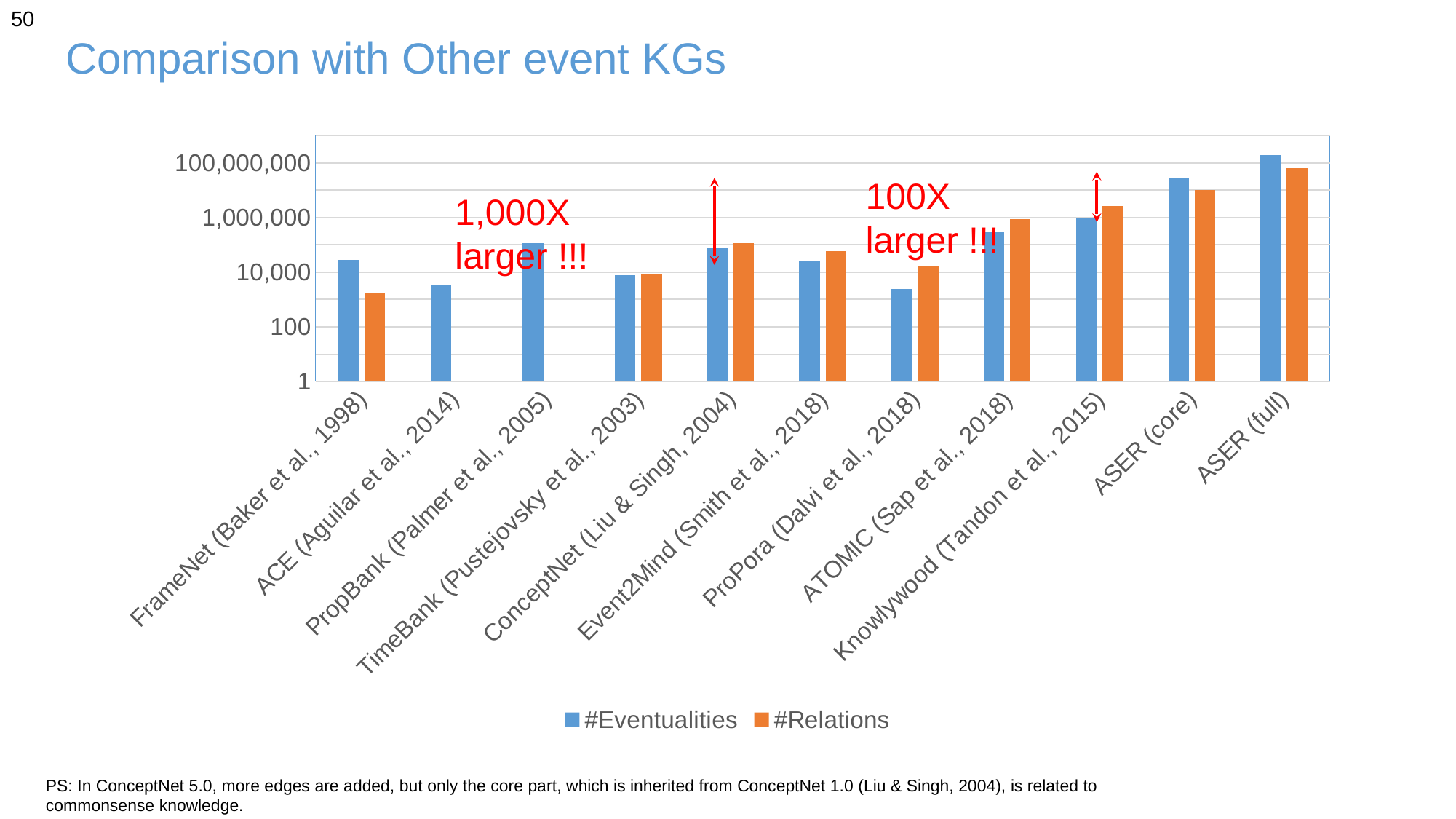
Is the #Relations value for Knowlywood (Tandon et al., 2015) greater or less than 1,000,000? greater For ConceptNet (Liu & Singh, 2004), which is larger: #Eventualities or #Relations? #Relations Is the #Eventualities value for ASER (full) greater or less than 100,000,000? greater What kind of chart is shown on the slide? bar chart Is the #Relations value for FrameNet (Baker et al., 1998) greater or less than 10,000? less Which category has the highest #Relations value? ASER (full) Which category has the highest #Eventualities value? ASER (full) Which two categories have no #Relations bar? ACE (Aguilar et al., 2014) and PropBank (Palmer et al., 2005) For ASER (core), which is larger: #Eventualities or #Relations? #Eventualities How many series does the legend list? 2 How many knowledge graphs (categories) are shown on the x axis? 11